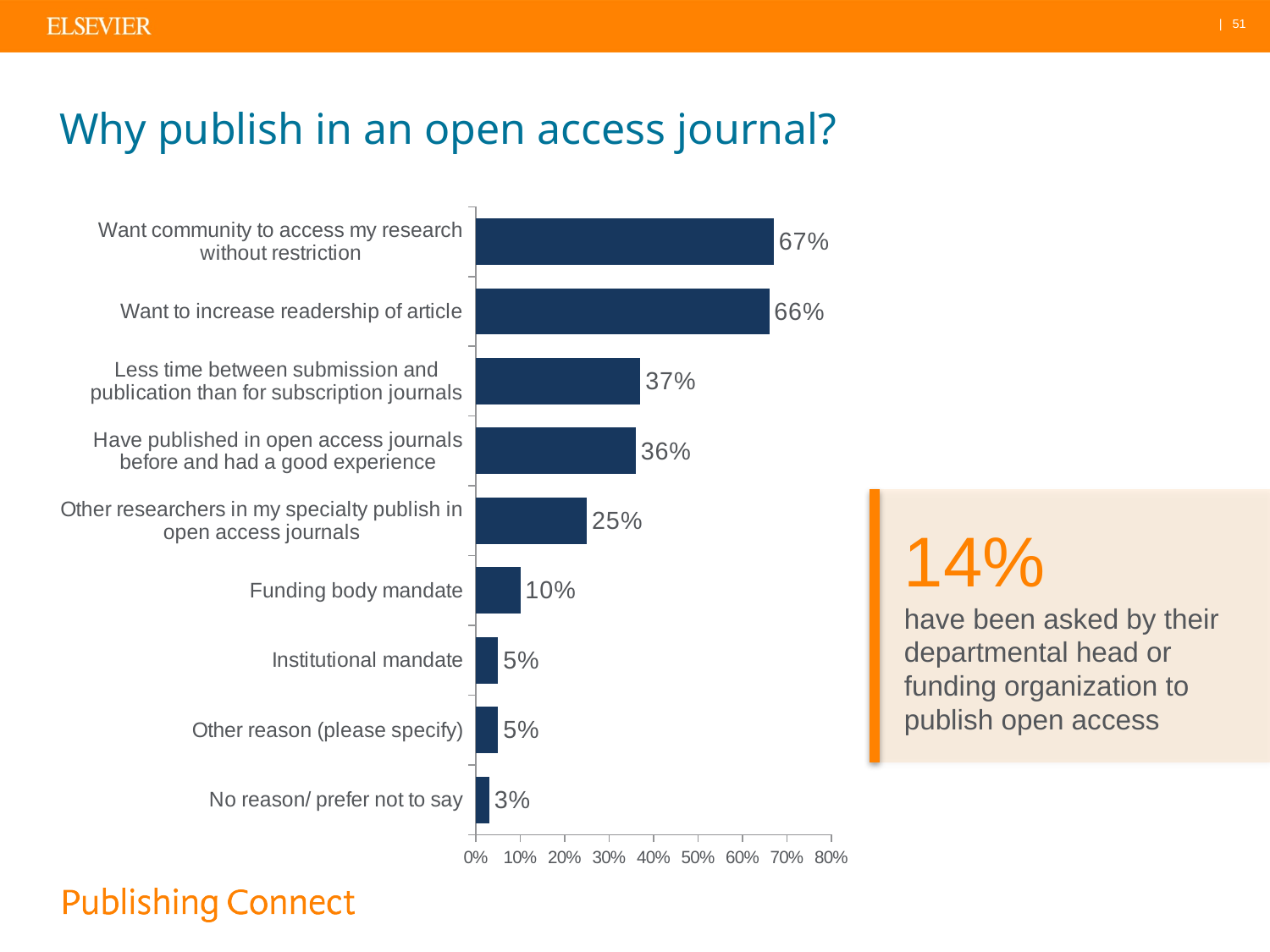
What kind of chart is shown on the slide? Bar chart Which reason has the highest percentage? Want community to access my research without restriction Which is larger: "Funding body mandate" or "Institutional mandate"? Funding body mandate What is the title of the slide containing the chart? Why publish in an open access journal? What is the difference between "Want to increase readership of article" and "Less time between submission and publication than for subscription journals"? 29% What percentage of respondents want the community to access their research without restriction? 67% What is the value for "Other researchers in my specialty publish in open access journals"? 25% How many reasons are listed in the chart? 9 What is the maximum value shown on the horizontal axis? 80% What is the value for "Funding body mandate"? 10% Which reason has the lowest percentage? No reason/ prefer not to say Is the value for "Have published in open access journals before and had a good experience" greater or less than 30%? greater